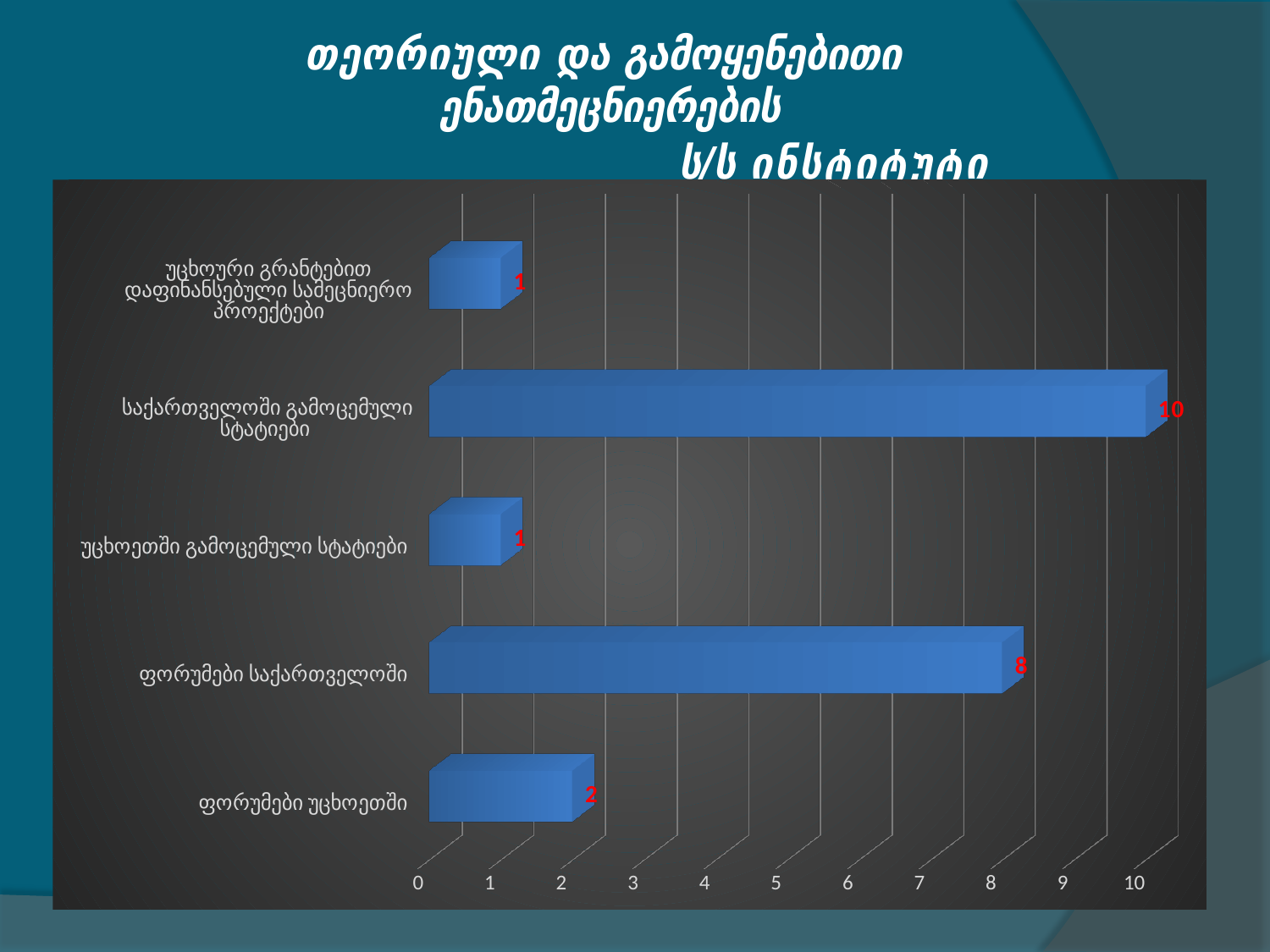
What kind of chart is shown on the slide? bar chart What is the value for ფორუმები საქართველოში? 8 What is the difference between the values for საქართველოში გამოცემული სტატიები and ფორუმები საქართველოში? 2 Which is larger, the value for ფორუმები უცხოეთში or the value for უცხოეთში გამოცემული სტატიები? ფორუმები უცხოეთში How many categories are shown in the chart? 5 What is the value for ფორუმები უცხოეთში? 2 What is the value for უცხოეთში გამოცემული სტატიები? 1 Which category has the highest value? საქართველოში გამოცემული სტატიები What is the highest value shown on the horizontal axis? 10 What is the value for საქართველოში გამოცემული სტატიები? 10 What is the difference between the values for ფორუმები საქართველოში and ფორუმები უცხოეთში? 6 Is the value for ფორუმები საქართველოში greater or less than 5? greater